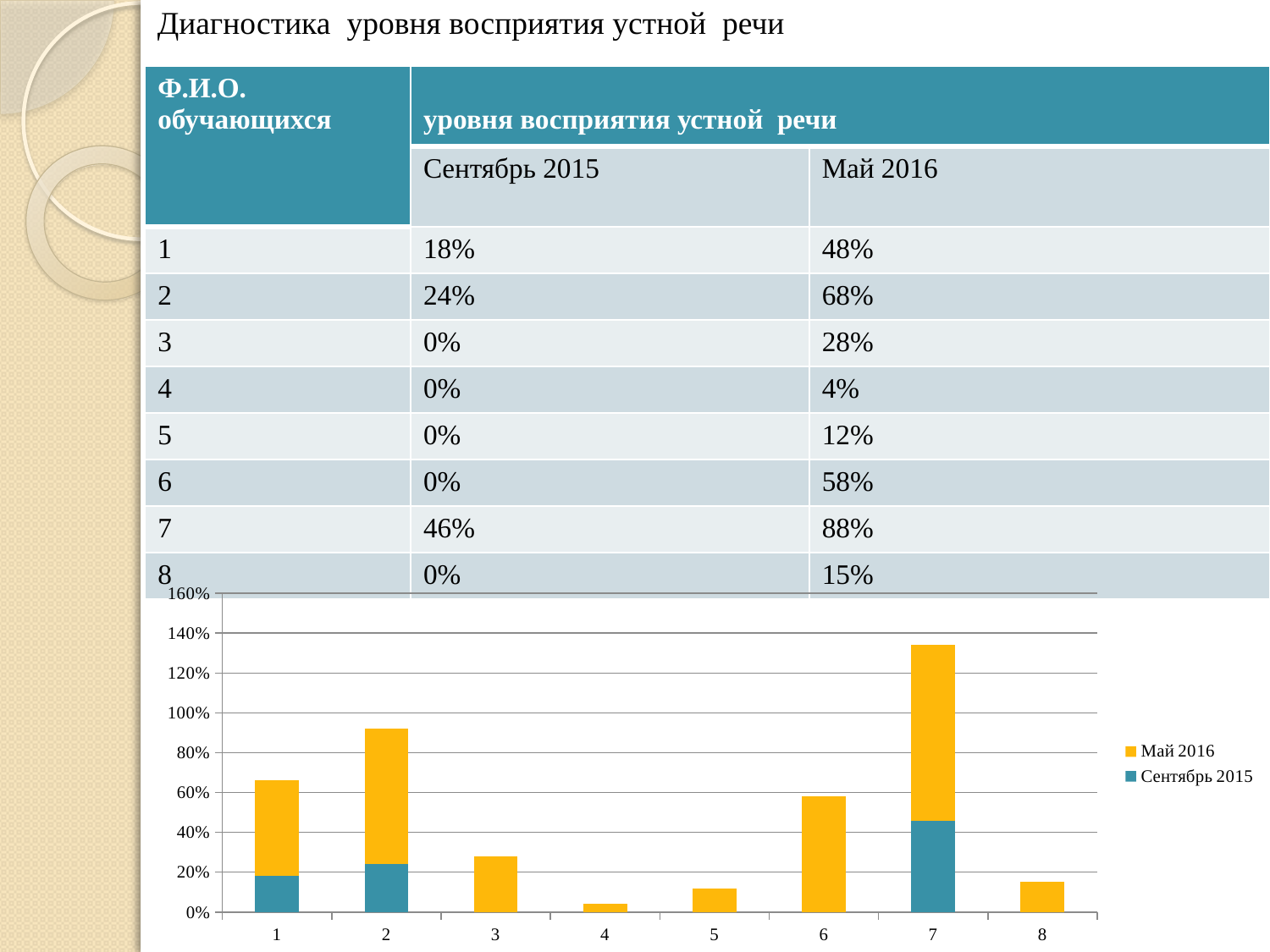
Which category has the lowest Май 2016 value? 4 How many categories are shown on the x axis of the chart? 8 Is the total stacked bar for category 2 greater or less than 80%? greater Is the total stacked bar for category 7 greater or less than 120%? greater What is the total of the stacked bar for category 7 (Сентябрь 2015 plus Май 2016)? 134% What are the two entries in the chart legend? Май 2016 and Сентябрь 2015 What kind of chart is shown at the bottom of the slide? bar chart Is the bar for category 4 greater or less than 20%? less Which category has the tallest stacked bar in the chart? 7 What is the difference between the Май 2016 values for student 7 and student 1? 40% What is the Май 2016 value for student 7? 88% How many series does the chart legend list? 2